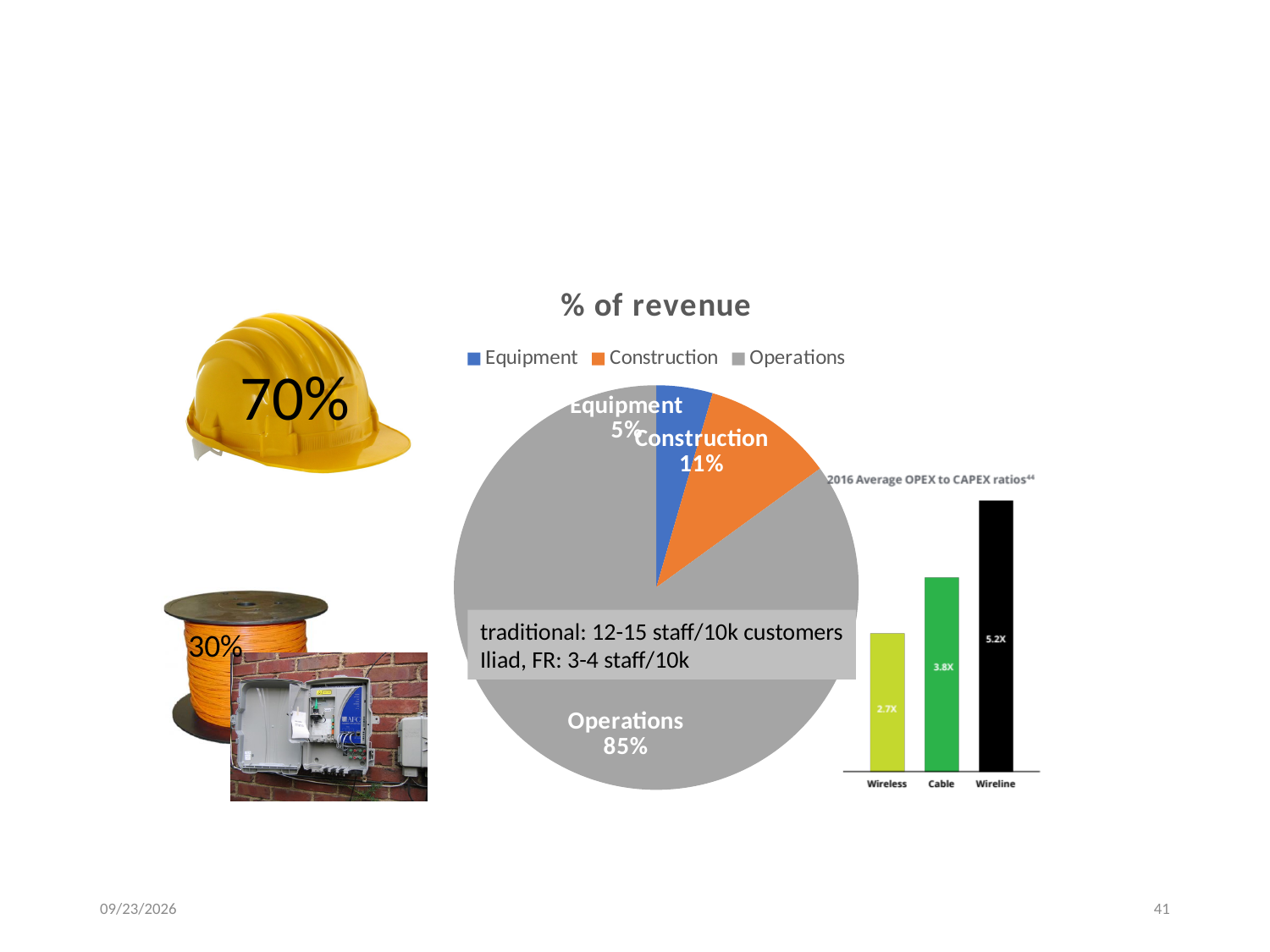
In the "% of revenue" pie chart, which category has the smallest slice? Equipment In the "% of revenue" pie chart, how many categories does the legend list? 3 In the "% of revenue" pie chart, which category has the largest slice? Operations What type of chart is the "% of revenue" chart? Pie chart In the "2016 Average OPEX to CAPEX ratios" chart, how many categories are shown? 3 In the "% of revenue" pie chart, what share of revenue is Construction? 11% In the "% of revenue" pie chart, what share of revenue is Operations? 85% In the "2016 Average OPEX to CAPEX ratios" chart, which category has the lowest ratio? Wireless In the "% of revenue" pie chart, what share of revenue is Equipment? 5% In the "2016 Average OPEX to CAPEX ratios" chart, what is the value for Cable? 3.8X What type of chart is the "2016 Average OPEX to CAPEX ratios" chart? Bar chart In the "2016 Average OPEX to CAPEX ratios" chart, what is the value for Wireline? 5.2X